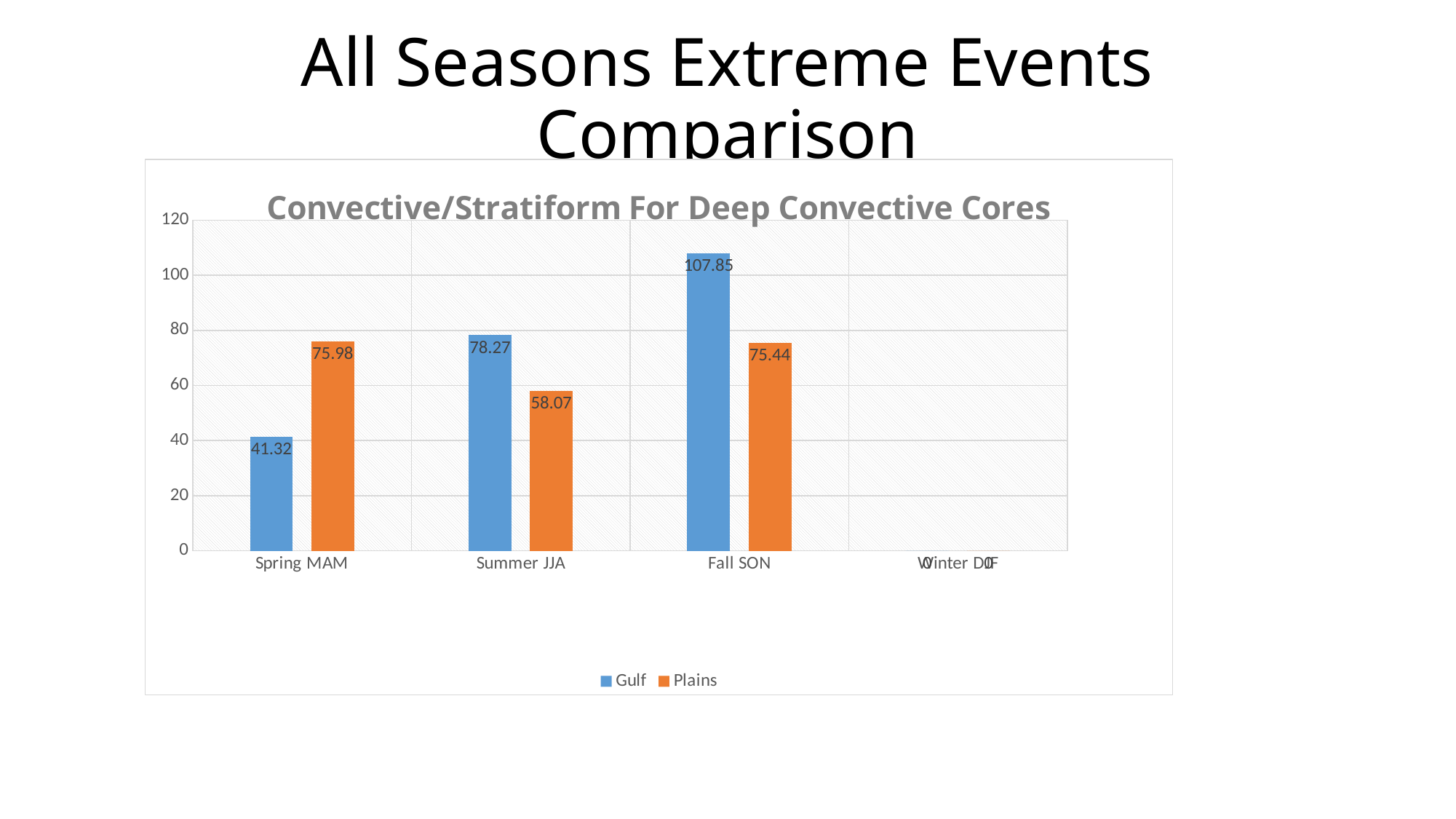
For Summer JJA, which series has the larger value, Gulf or Plains? Gulf What is the difference between the Gulf and Plains values for Spring MAM? 34.66 Which season has the lowest Plains value among Spring MAM, Summer JJA and Fall SON? Summer JJA What is the Plains value for Summer JJA? 58.07 Is the Gulf value for Fall SON greater or less than 100? greater What is the Plains value for Spring MAM? 75.98 How many series does the legend list? 2 What is the Gulf value for Summer JJA? 78.27 Which season has the highest Gulf value? Fall SON What kind of chart is shown on the slide? Bar chart How many seasons are shown on the x axis? 4 What is the Gulf value for Fall SON? 107.85